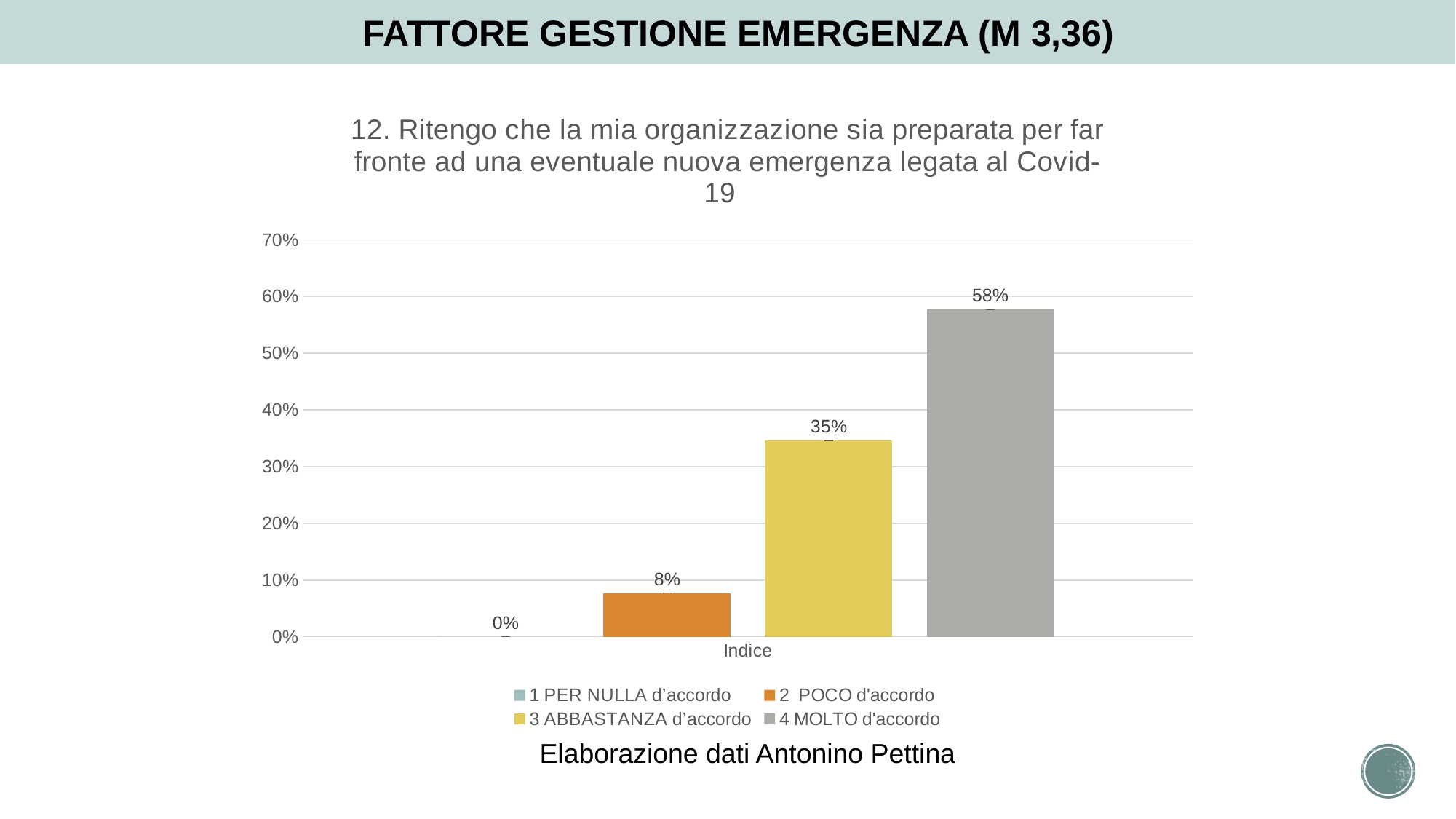
What is the label on the x axis under the bars? Indice What is the difference between the values for "4 MOLTO d'accordo" and "3 ABBASTANZA d'accordo"? 23% Which series has the lowest value? 1 PER NULLA d'accordo What is the value for "3 ABBASTANZA d'accordo"? 35% What is the value for "1 PER NULLA d'accordo"? 0% What is the value for "2 POCO d'accordo"? 8% How many series does the legend list? 4 Is the value for "4 MOLTO d'accordo" greater or less than 50%? greater Which is larger, the value for "2 POCO d'accordo" or "3 ABBASTANZA d'accordo"? 3 ABBASTANZA d'accordo What kind of chart is shown on the slide? bar chart What is the value for "4 MOLTO d'accordo"? 58% Which series has the highest value? 4 MOLTO d'accordo